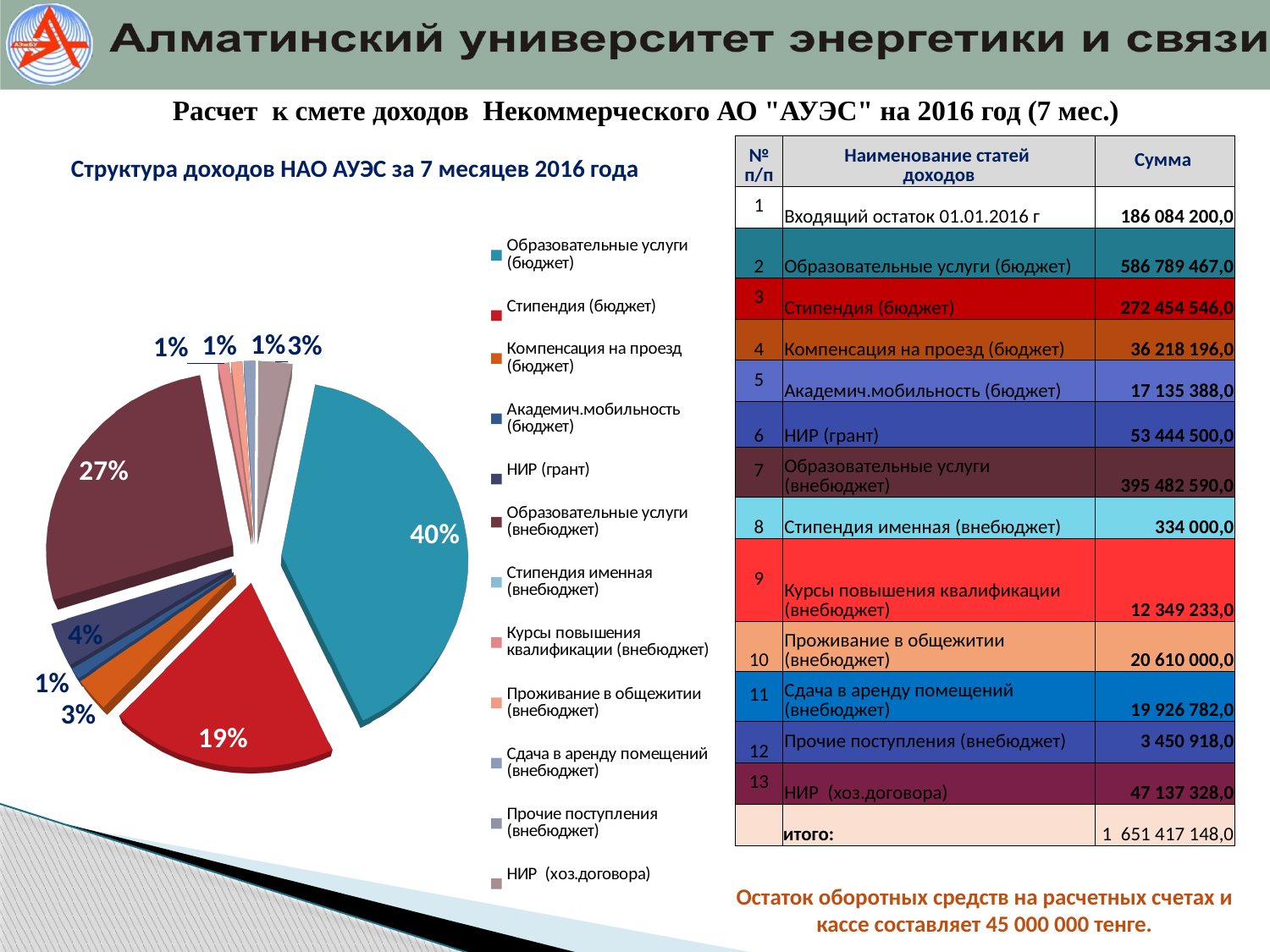
Which category has the largest slice in the pie chart? Образовательные услуги (бюджет) What colour is the slice for Образовательные услуги (бюджет)? Teal (blue-green) What type of chart is shown on the slide? Pie chart What percentage is shown for Стипендия (бюджет) in the pie chart? 19% Which is larger in the pie chart: Стипендия (бюджет) or Образовательные услуги (внебюджет)? Образовательные услуги (внебюджет) What share of the pie is labelled for Образовательные услуги (внебюджет)? 27% By how many percentage points does Образовательные услуги (бюджет) exceed Стипендия (бюджет)? 21 What is the title of the pie chart? Структура доходов НАО АУЭС за 7 месяцев 2016 года What percentage does the НИР (грант) slice show? 4% What share of the pie does Образовательные услуги (бюджет) represent? 40% How many categories are listed in the pie chart's legend? 12 Is the share for Образовательные услуги (внебюджет) greater or less than 25%? greater